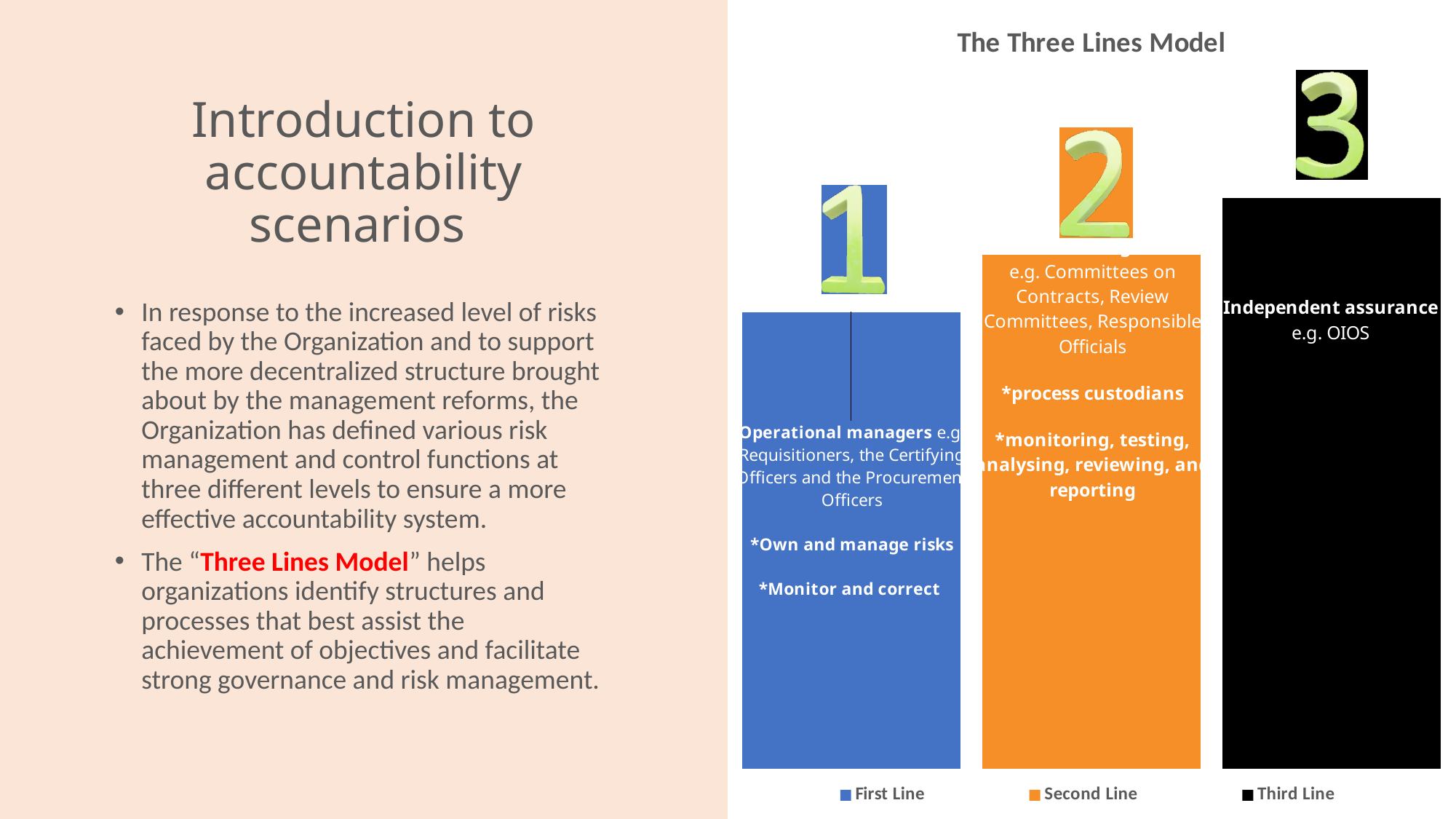
Which bar is taller, Second Line or Third Line? Third Line Which series has the tallest bar in the chart? Third Line What kind of chart is shown on the right side of the slide? Bar chart What colour is the Second Line bar in the chart? Orange Which series has the shortest bar in the chart? First Line Do the bar heights rise or fall from left to right across the chart? Rise What is the title of the chart on the slide? The Three Lines Model Which bar is taller, First Line or Second Line? Second Line How many bars are plotted in the chart? 3 How many series does the chart's legend list? 3